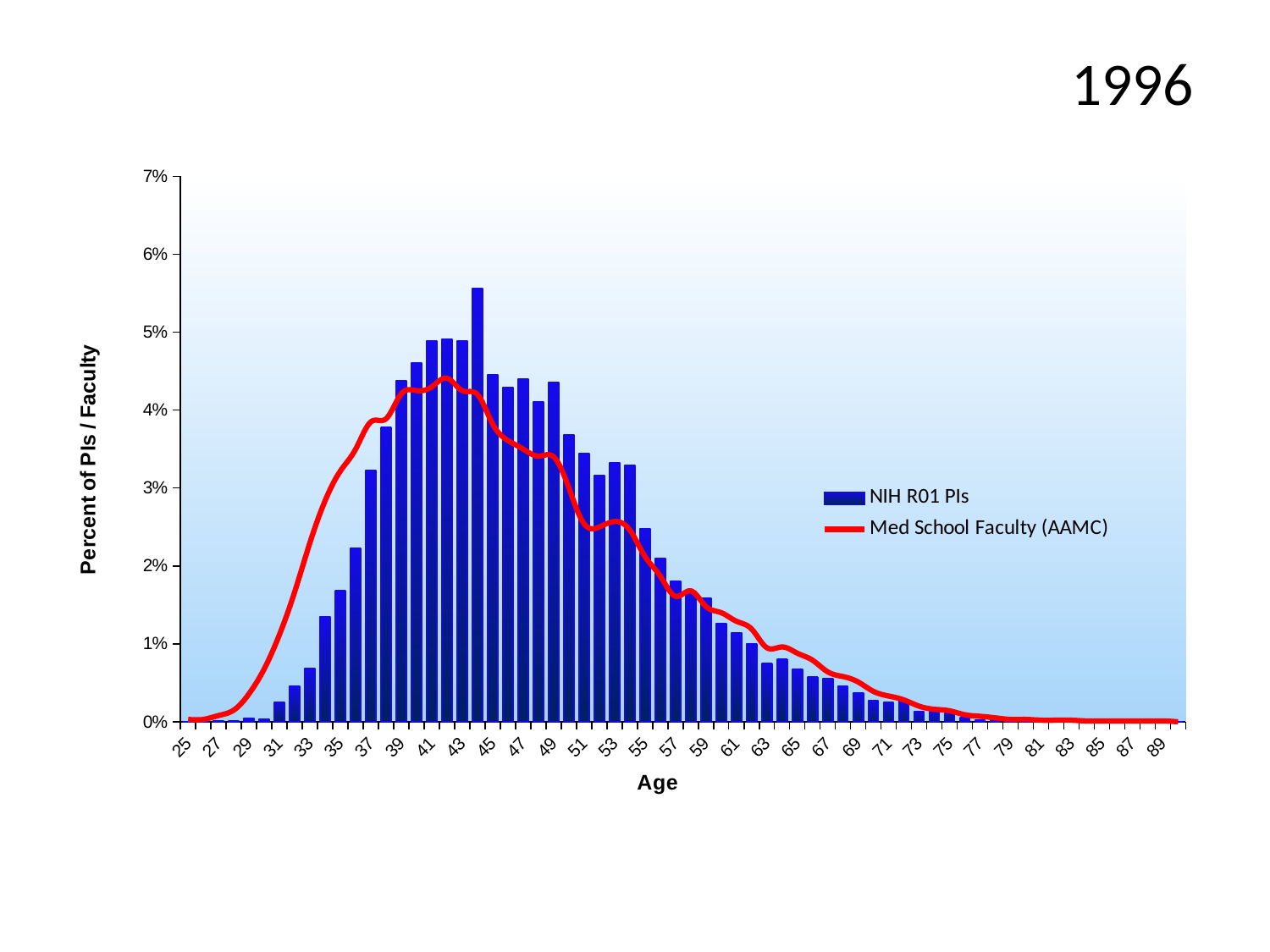
Is the Med School Faculty (AAMC) value at age 55 greater or less than 3%? less What kind of chart is shown on the slide? Bar chart with a line overlay Is the NIH R01 PIs value at age 37 greater or less than 4%? less At which age is the NIH R01 PIs bar tallest? 44 What is the title shown at the top of the slide? 1996 What are the two series named in the legend? NIH R01 PIs; Med School Faculty (AAMC) Is the NIH R01 PIs value at age 31 greater or less than 1%? less Do the NIH R01 PIs bars rise or fall as age increases from 45 to 75? Fall How many series does the legend list? 2 Which is larger, the NIH R01 PIs bar at age 41 or at age 61? Age 41 What is the label of the vertical axis? Percent of PIs / Faculty